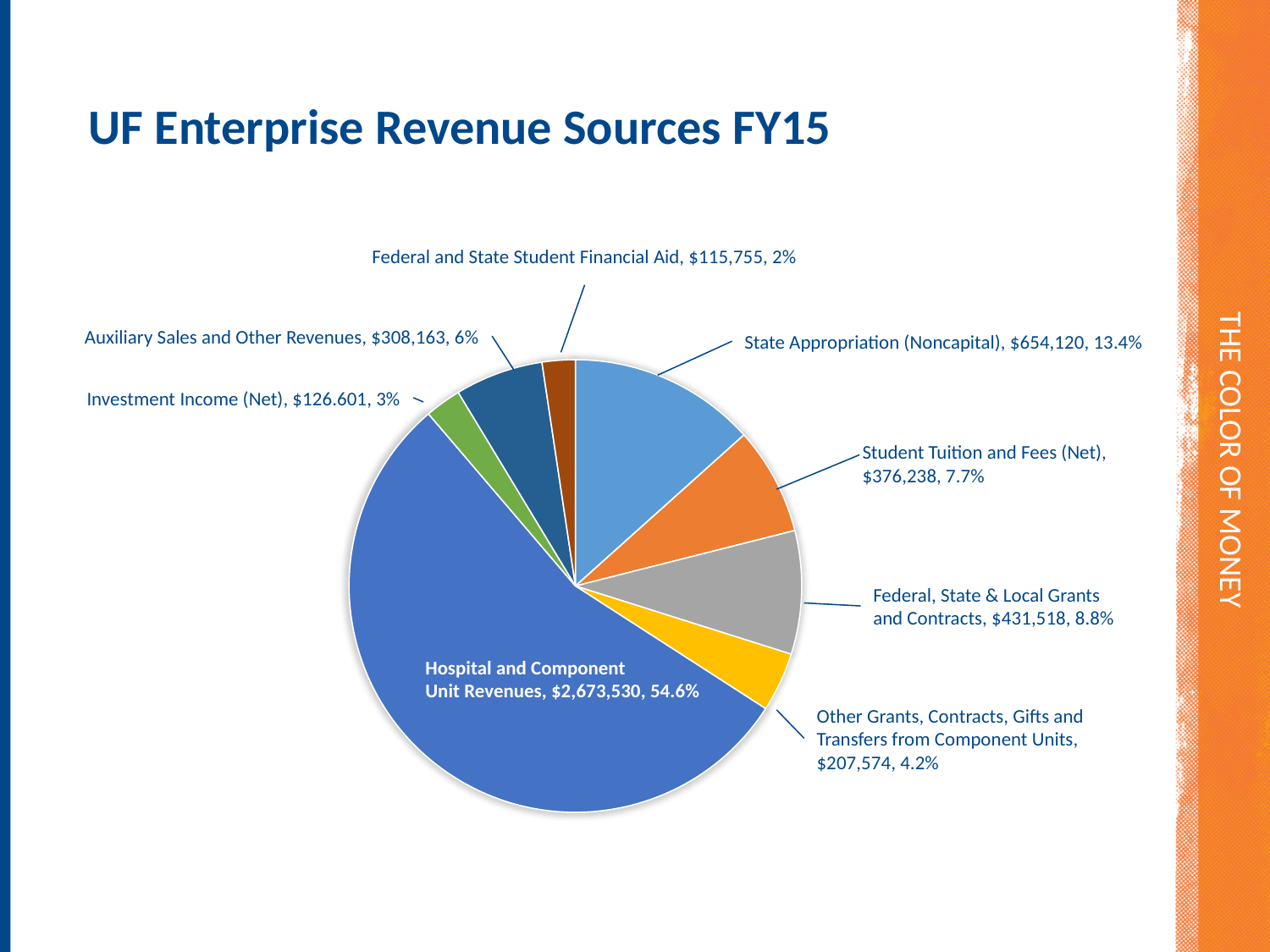
What is the difference in dollars between State Appropriation (Noncapital) and Student Tuition and Fees (Net)? $277,882 Which is larger, Auxiliary Sales and Other Revenues or Other Grants, Contracts, Gifts and Transfers from Component Units? Auxiliary Sales and Other Revenues What percentage is shown for Investment Income (Net)? 3% What is the dollar value shown for State Appropriation (Noncapital)? $654,120 What kind of chart is shown on the slide? pie chart What is the dollar value shown for Student Tuition and Fees (Net)? $376,238 Which revenue source is the largest slice of the pie? Hospital and Component Unit Revenues What is the title of the chart on the slide? UF Enterprise Revenue Sources FY15 What share of the pie is Hospital and Component Unit Revenues? 54.6% What share of the pie is Federal, State & Local Grants and Contracts? 8.8% How many slices does the pie chart have? 8 Which revenue source is the smallest slice of the pie? Federal and State Student Financial Aid